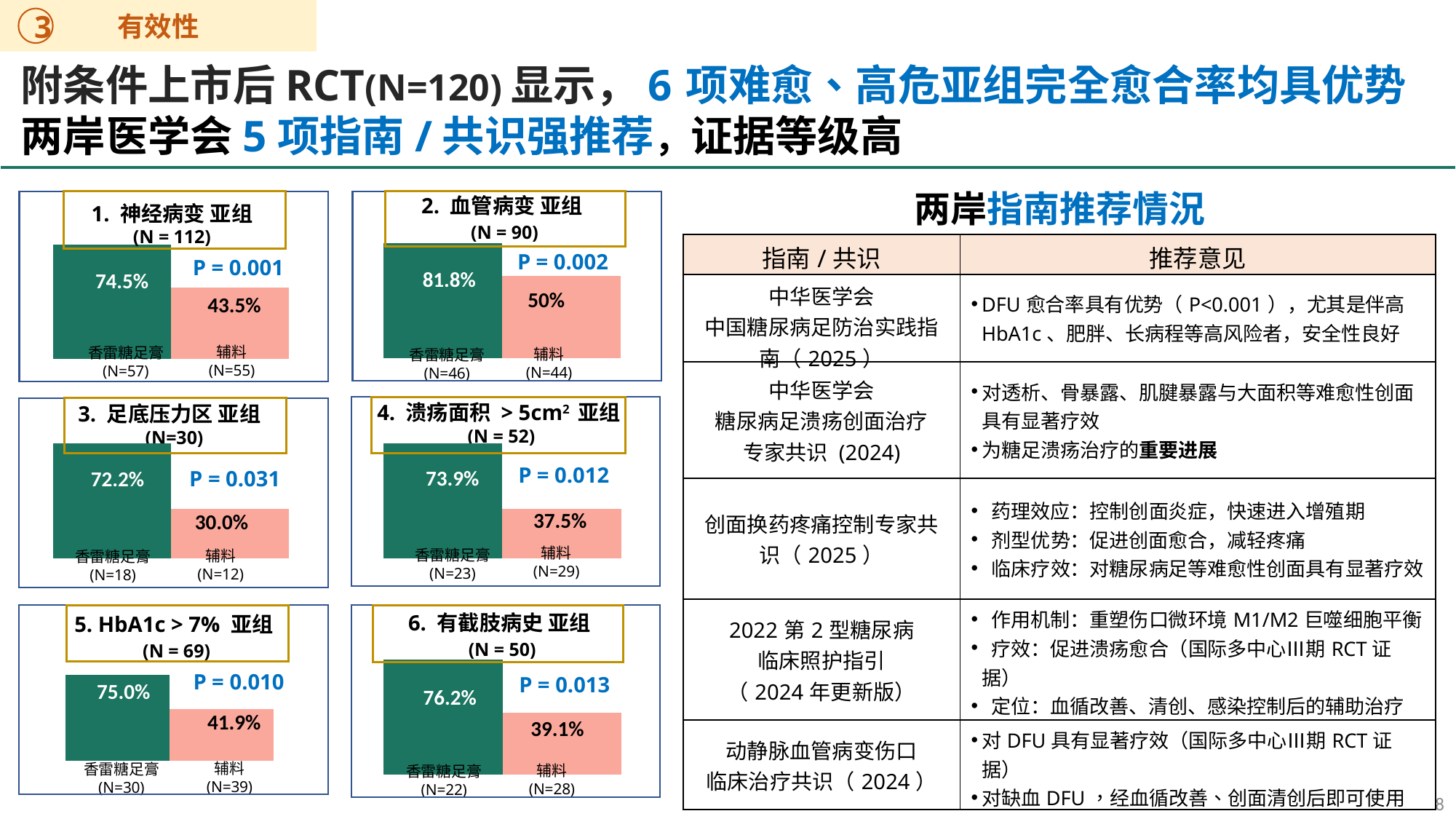
Across the six subgroup charts, which subgroup has the highest 香雷糖足膏 value? 2. 血管病变 亚组 How many bars are shown in the chart titled "1. 神经病变 亚组"? 2 In the chart titled "4. 溃疡面积 > 5cm² 亚组", which bar is higher, 香雷糖足膏 or 辅料? 香雷糖足膏 In the chart titled "1. 神经病变 亚组", what is the value for 香雷糖足膏? 74.5% What kind of chart is used for the six subgroup panels on the left of the slide? bar chart What P value is printed on the chart titled "2. 血管病变 亚组"? P = 0.002 In the chart titled "3. 足底压力区 亚组", what is the difference between the 香雷糖足膏 value and the 辅料 value? 42.2% In the chart titled "2. 血管病变 亚组", what is the value for 辅料? 50% In the chart titled "6. 有截肢病史 亚组", what is the difference between the 香雷糖足膏 value and the 辅料 value? 37.1% In the chart titled "5. HbA1c > 7% 亚组", what is the value for 辅料? 41.9% Across the six subgroup charts, which subgroup has the lowest 辅料 value? 3. 足底压力区 亚组 In the chart titled "6. 有截肢病史 亚组", what is the value for 香雷糖足膏? 76.2%